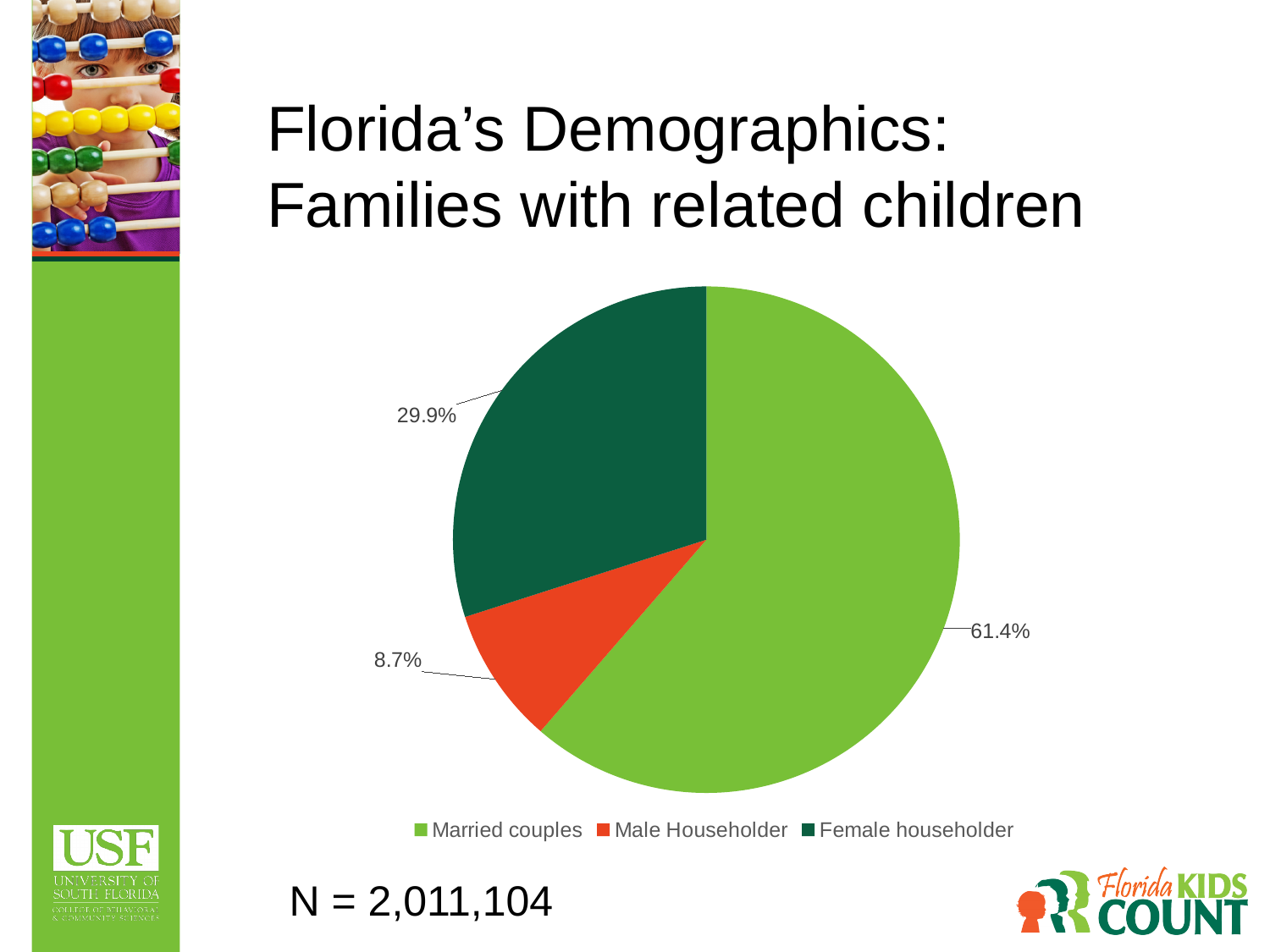
What is the N value shown below the chart? 2,011,104 Which category has the largest slice of the pie? Married couples How many categories does the pie chart show? 3 What is the difference in percentage points between Married couples and Female householder? 31.5 What colour is the Male Householder slice? Red-orange What percentage of the pie is Female householder? 29.9% Which is larger, the Female householder slice or the Male Householder slice? Female householder Which category has the smallest slice of the pie? Male Householder What percentage of the pie is Male Householder? 8.7% What is the difference in percentage points between Female householder and Male Householder? 21.2 What share of families with related children are married couples? 61.4% What kind of chart is shown on the slide? Pie chart